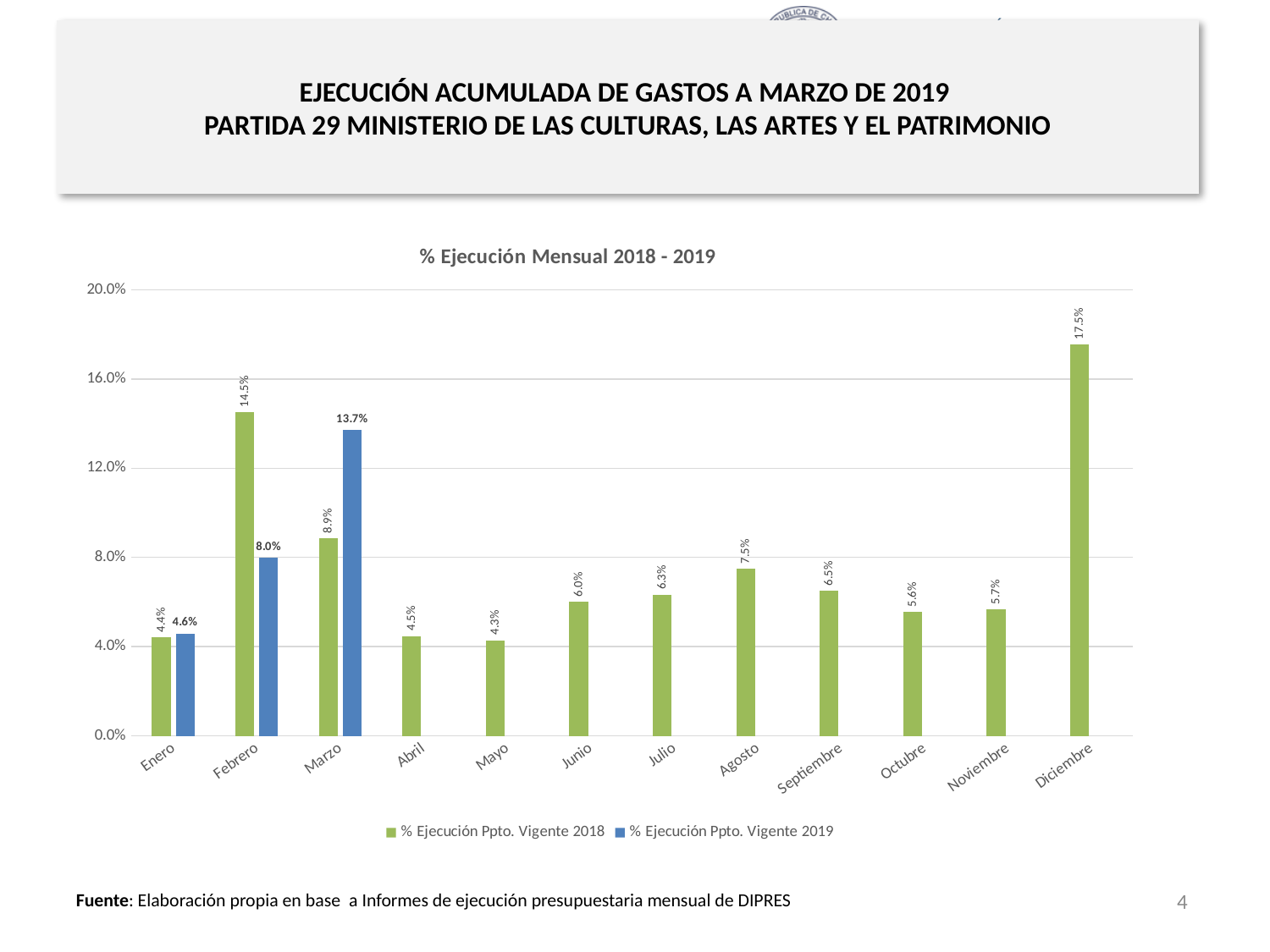
How many months are shown on the x axis? 12 Is the value for Agosto in the 2018 series greater or less than 8.0%? less What is the value for Diciembre in the % Ejecución Ppto. Vigente 2018 series? 17.5% Which month has the lowest value in the % Ejecución Ppto. Vigente 2018 series? Mayo What kind of chart is shown on the slide? Bar chart What is the title of the chart? % Ejecución Mensual 2018 - 2019 Which month has the highest value in the % Ejecución Ppto. Vigente 2018 series? Diciembre How many series does the legend list? 2 What is the value for Marzo in the % Ejecución Ppto. Vigente 2019 series? 13.7% What is the difference between the 2019 and 2018 values for Marzo? 4.8% For Febrero, which series has the larger value, 2018 or 2019? % Ejecución Ppto. Vigente 2018 What is the value for Febrero in the % Ejecución Ppto. Vigente 2018 series? 14.5%